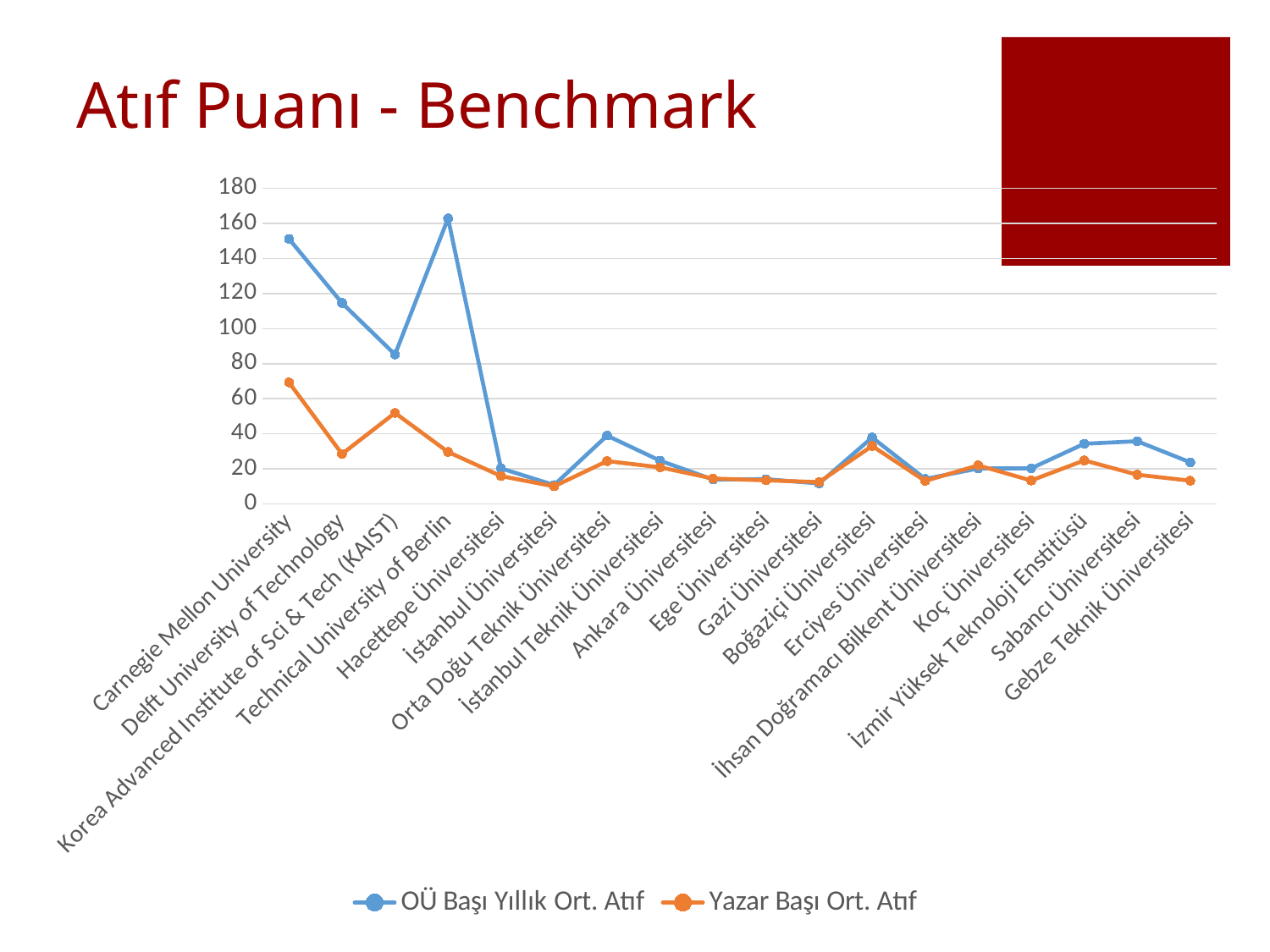
Is the Yazar Başı Ort. Atıf value for Carnegie Mellon University greater or less than 60? greater How many universities are shown on the x axis? 18 What kind of chart is shown on the slide? Line chart Is the OÜ Başı Yıllık Ort. Atıf value for Korea Advanced Institute of Sci & Tech (KAIST) greater or less than 100? less How many series does the legend list? 2 Is the Yazar Başı Ort. Atıf value for Korea Advanced Institute of Sci & Tech (KAIST) greater or less than 40? greater What is the title of the slide containing the chart? Atıf Puanı - Benchmark Which has the larger OÜ Başı Yıllık Ort. Atıf value: Technical University of Berlin or Delft University of Technology? Technical University of Berlin Which university has the highest value for OÜ Başı Yıllık Ort. Atıf? Technical University of Berlin Which is larger for Delft University of Technology: OÜ Başı Yıllık Ort. Atıf or Yazar Başı Ort. Atıf? OÜ Başı Yıllık Ort. Atıf Which university has the highest value for Yazar Başı Ort. Atıf? Carnegie Mellon University